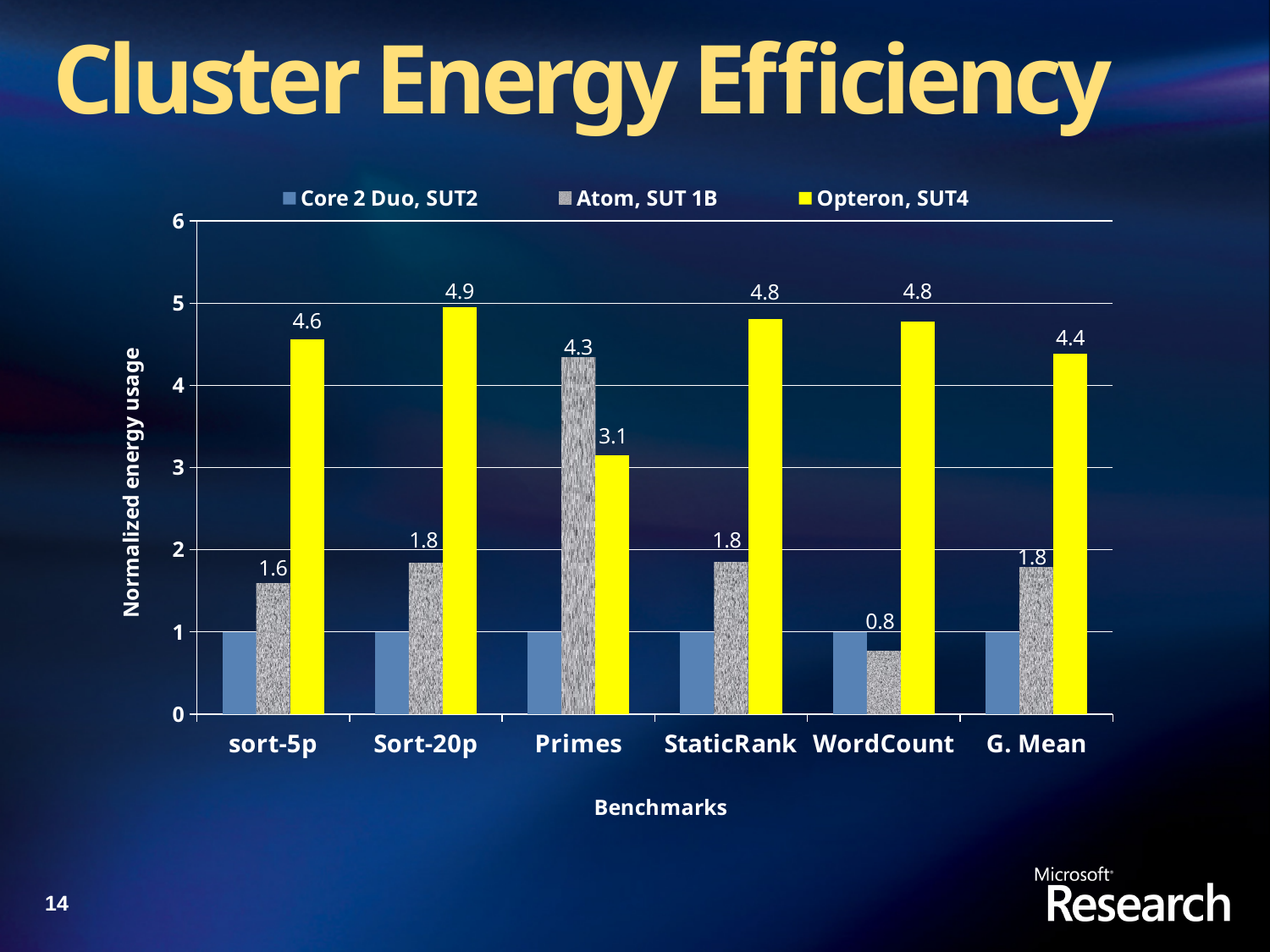
Which benchmark has the highest value for Opteron, SUT4? Sort-20p What is the value for Atom, SUT 1B on the WordCount benchmark? 0.8 What is the value for Opteron, SUT4 on the Sort-20p benchmark? 4.9 How many series does the legend list? 3 How many benchmark categories are shown on the x axis? 6 Is the value for Core 2 Duo, SUT2 on StaticRank greater or less than 2? less What is the difference between the Opteron, SUT4 and Atom, SUT 1B values for sort-5p? 3.0 What is the value for Opteron, SUT4 on the G. Mean category? 4.4 Which benchmark has the lowest value for Atom, SUT 1B? WordCount For the Primes benchmark, which is larger: Atom, SUT 1B or Opteron, SUT4? Atom, SUT 1B What kind of chart is shown on the slide? bar chart What is the value for Atom, SUT 1B on the Primes benchmark? 4.3